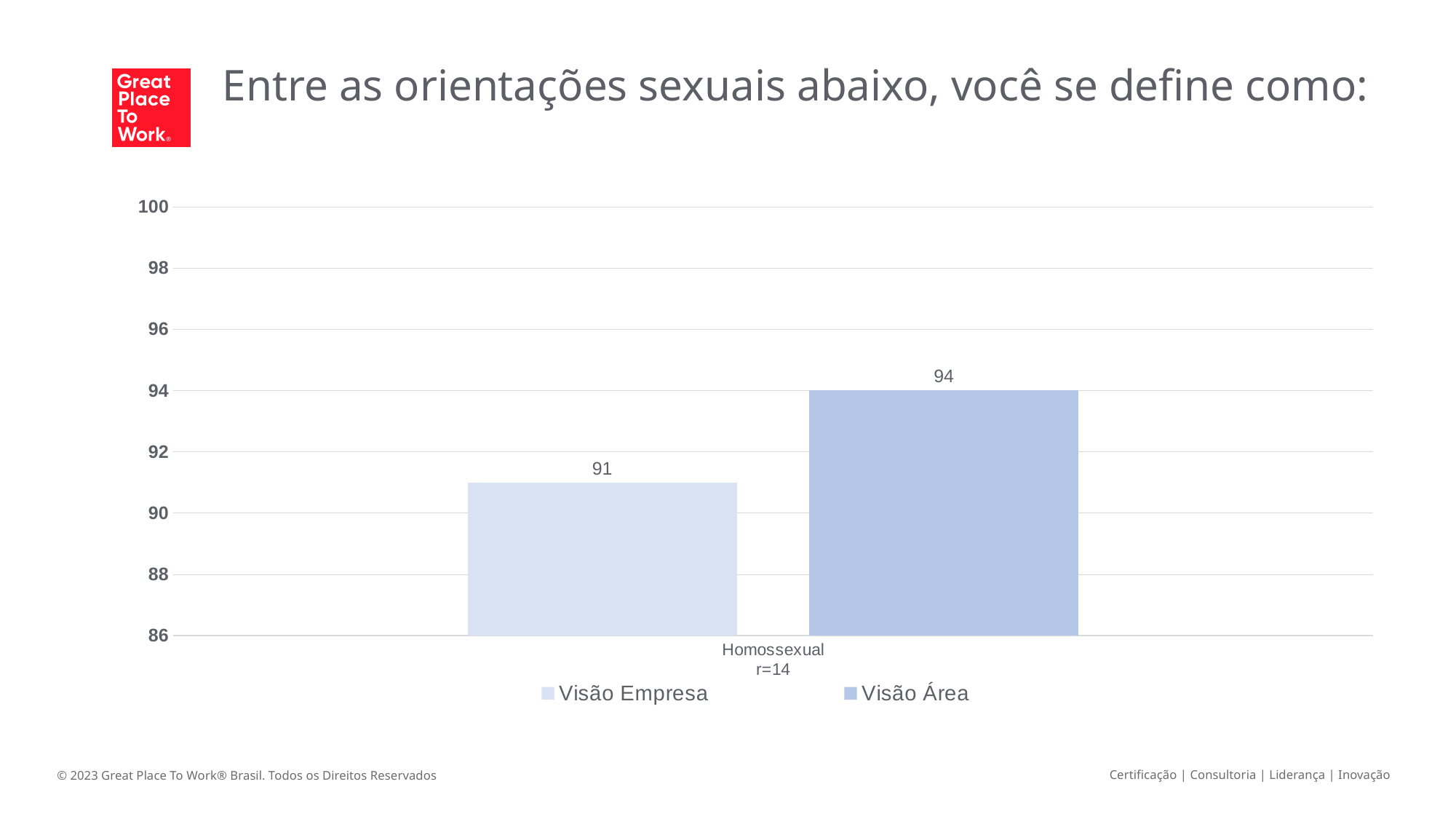
What kind of chart is shown on the slide? bar chart How many series does the legend list? 2 What is the value for Visão Área for the Homossexual category? 94 Is the value for Visão Área greater or less than 92? greater How many categories are shown on the x axis? 1 What is the category label shown on the x axis? Homossexual r=14 Which series has the lowest value on the chart? Visão Empresa What is the value for Visão Empresa for the Homossexual category? 91 What is the difference between the Visão Área and Visão Empresa values for the Homossexual category? 3 Is the value for Visão Empresa greater or less than 92? less Which series has the higher value for the Homossexual category, Visão Empresa or Visão Área? Visão Área What is the title of the chart? Entre as orientações sexuais abaixo, você se define como: